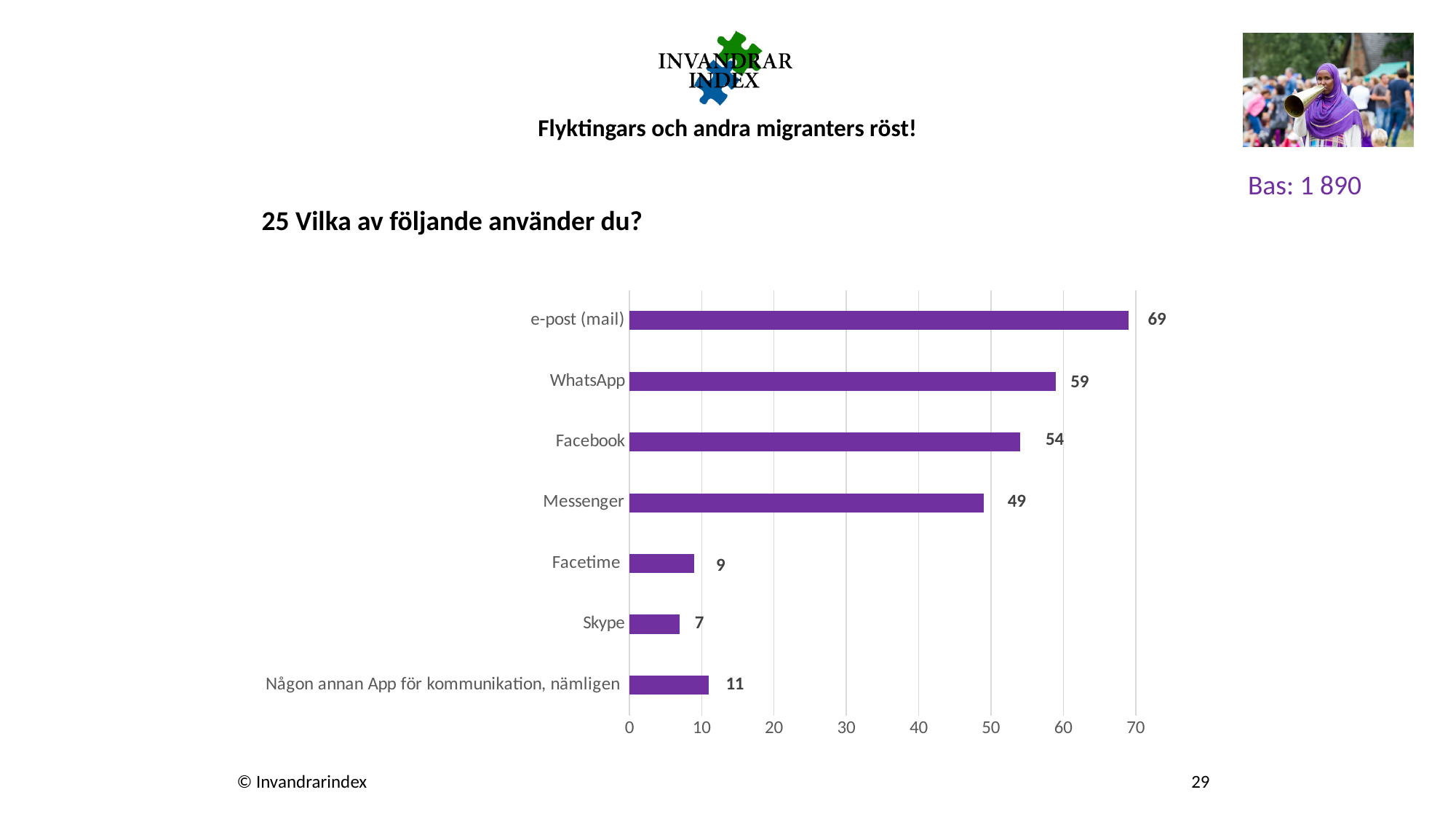
Which category has the lowest value? Skype Which is larger, the value for Facetime or the value for Skype? Facetime What kind of chart is shown on the slide? bar chart What is the value for Messenger? 49 What is the value for WhatsApp? 59 How many categories are shown in the chart? 7 Is the value for Facebook greater or less than 50? greater What is the value for 'Någon annan App för kommunikation, nämligen'? 11 What is the value for Skype? 7 What is the title of the chart? 25 Vilka av följande använder du? What is the difference between the values for e-post (mail) and Facebook? 15 Which category has the highest value? e-post (mail)